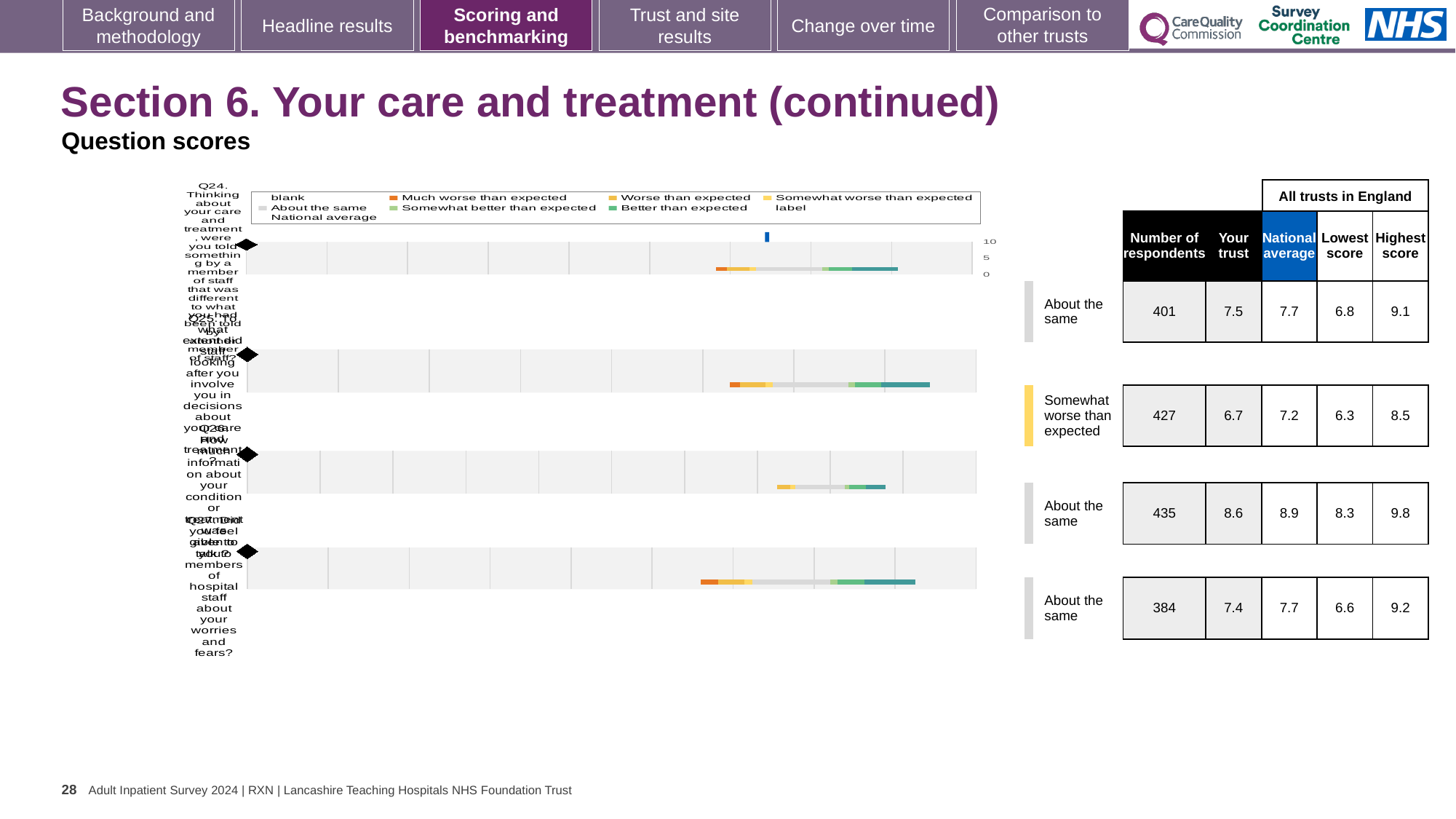
Which question row has the highest 'Your trust' score? Q26 (third row) What is the 'Your trust' score for Q25 (the second row)? 6.7 What is the lowest score among all trusts in England for Q26 (the third row)? 8.3 For Q24 (the first row), is the 'Your trust' score higher or lower than the national average? lower What kind of chart is used to show the question scores? bar chart Which question row has the lowest 'Your trust' score? Q25 (second row) Which benchmark category is shown for Q25 (the second row)? Somewhat worse than expected What is the highest score among all trusts in England for Q27 (the fourth row)? 9.2 In the table next to the chart, what is the number of respondents for Q24 (the first row)? 401 How many question rows are plotted in the chart? 4 What is the national average score for Q26 (the third row)? 8.9 For Q25 (the second row), what is the difference between the national average and the 'Your trust' score? 0.5